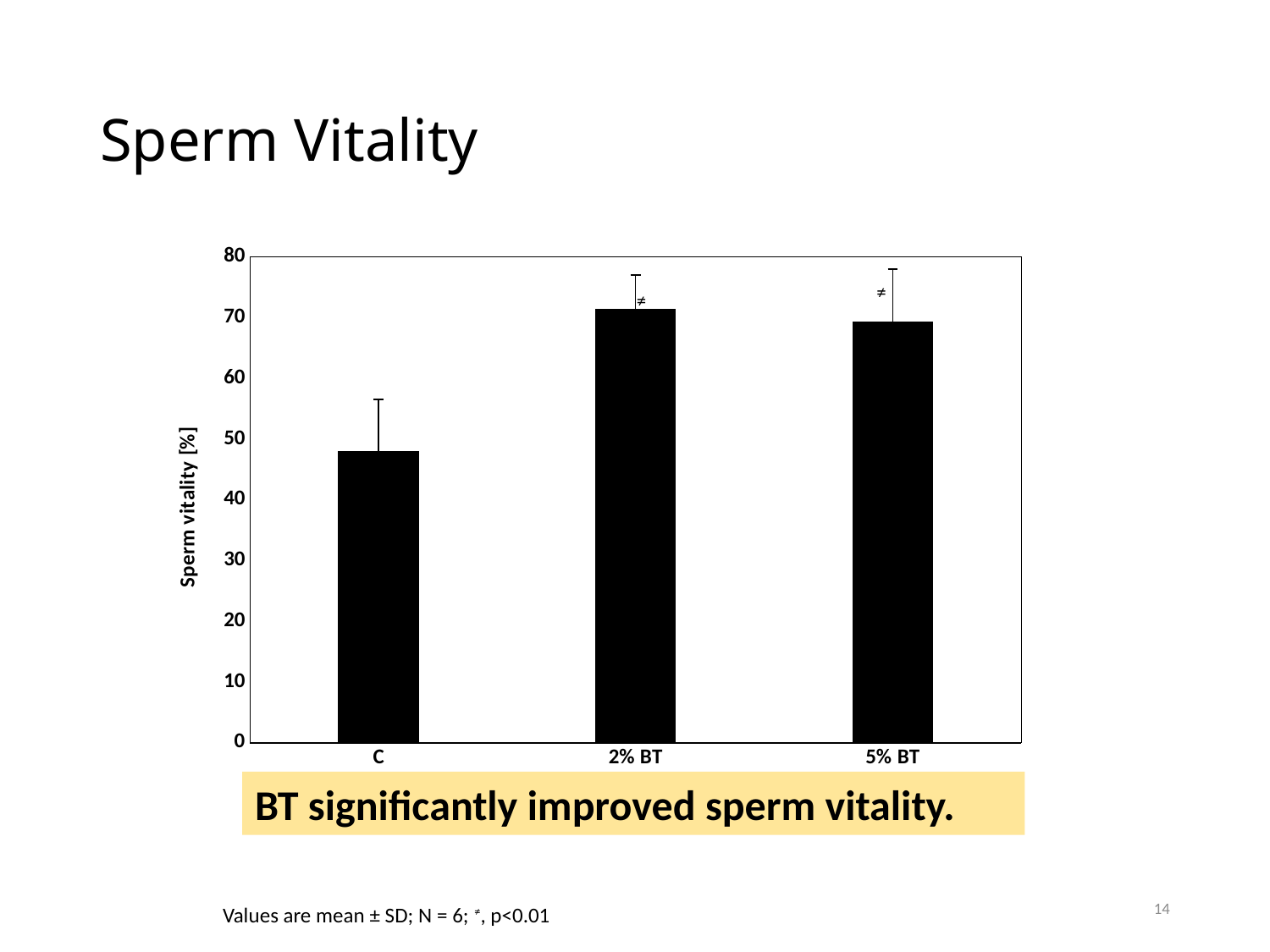
Which is larger, the value for C or the value for 2% BT? 2% BT How many categories are plotted on the x axis? 3 Which is larger, the value for C or the value for 5% BT? 5% BT What is the label of the y axis? Sperm vitality [%] Is the value for C greater or less than 40? greater Is the value for 5% BT greater or less than 60? greater What kind of chart is shown on the slide? bar chart Is the value for 2% BT greater or less than 80? less What colour are the bars in the chart? black Which category has the lowest sperm vitality? C